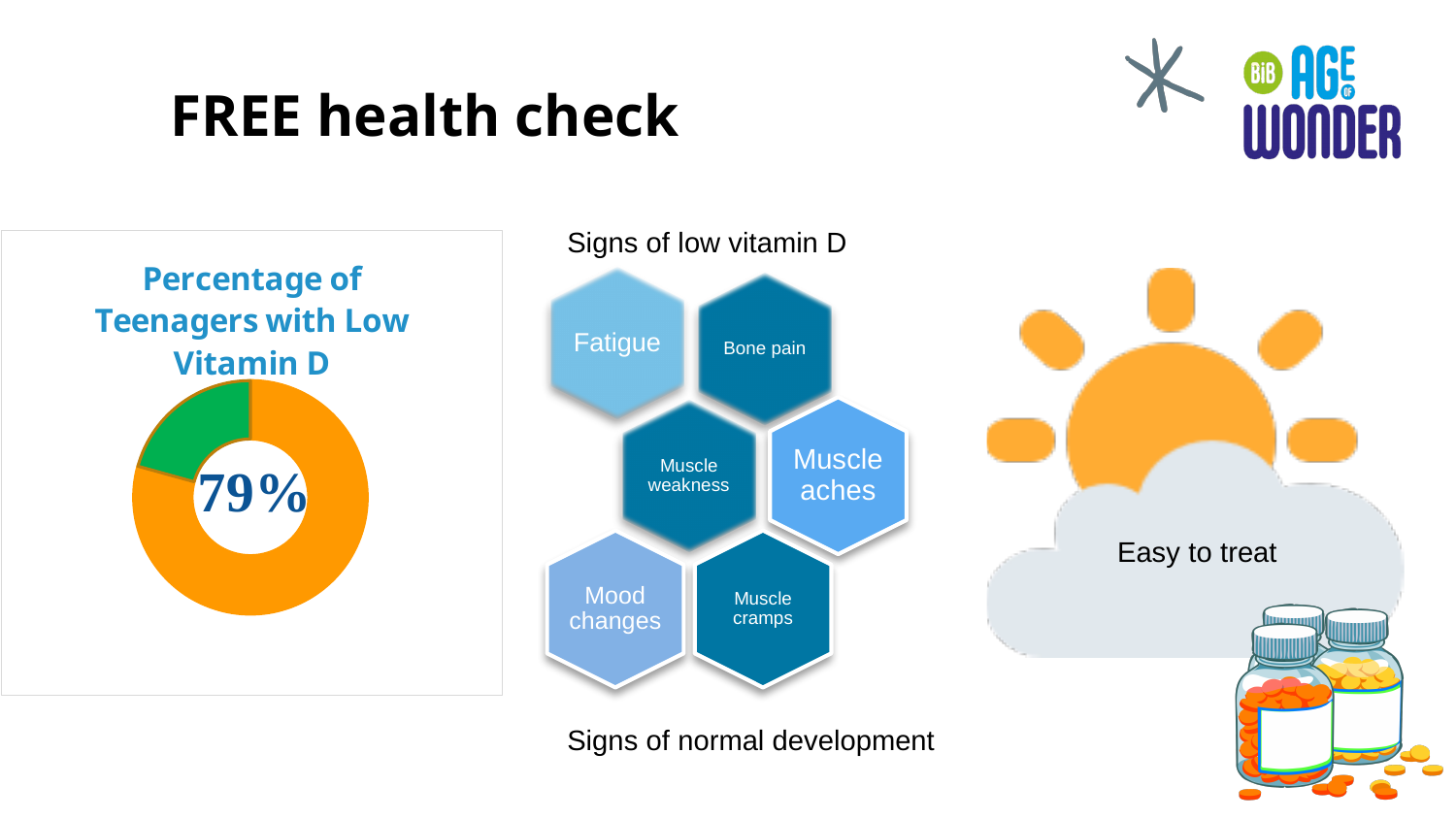
According to the chart, what percentage of teenagers have low vitamin D? 79% What percentage is printed in the centre of the doughnut chart? 79% Is the share of the orange slice in the doughnut chart greater or less than 50%? greater Is the share of the green slice in the doughnut chart greater or less than 50%? less Which slice of the doughnut chart is the smallest? The green slice How many slices does the doughnut chart have? 2 What is the title of the chart on the left of the slide? Percentage of Teenagers with Low Vitamin D What colour is the largest slice of the doughnut chart? Orange What kind of chart is shown on the left of the slide? Doughnut chart Which slice of the doughnut chart is larger, the orange one or the green one? Orange